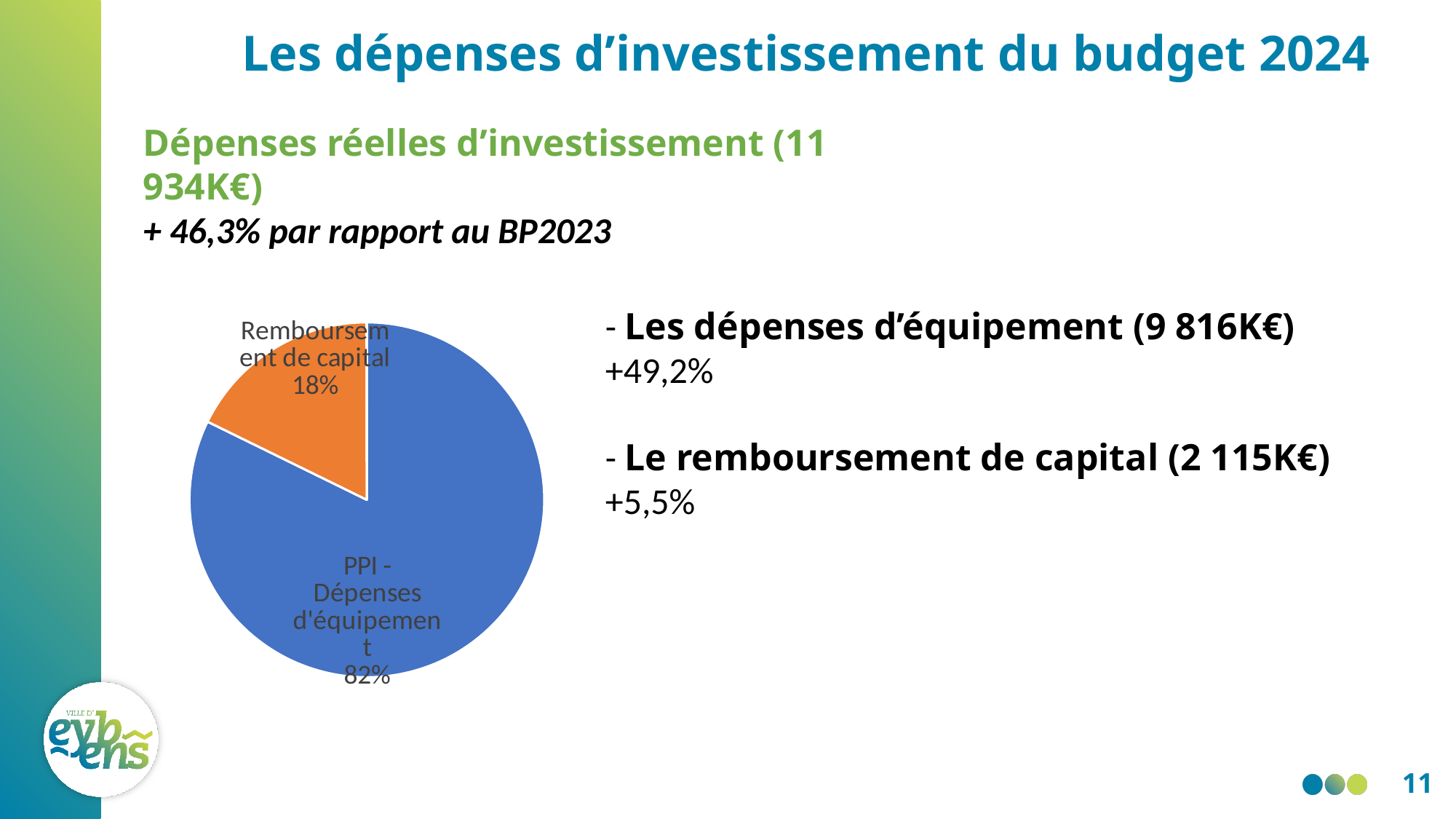
What kind of chart is shown on the slide? pie chart Which slice of the pie chart is the largest? PPI - Dépenses d'équipement What colour is the "PPI - Dépenses d'équipement" slice in the pie chart? blue Which slice of the pie chart is the smallest? Remboursement de capital What share of the pie does "Remboursement de capital" represent? 18% What share of the pie does "PPI - Dépenses d'équipement" represent? 82% Which is larger in the pie chart: "PPI - Dépenses d'équipement" or "Remboursement de capital"? PPI - Dépenses d'équipement What is the difference in percentage points between the "PPI - Dépenses d'équipement" slice and the "Remboursement de capital" slice? 64 percentage points What colour is the "Remboursement de capital" slice in the pie chart? orange How many slices does the pie chart have? 2